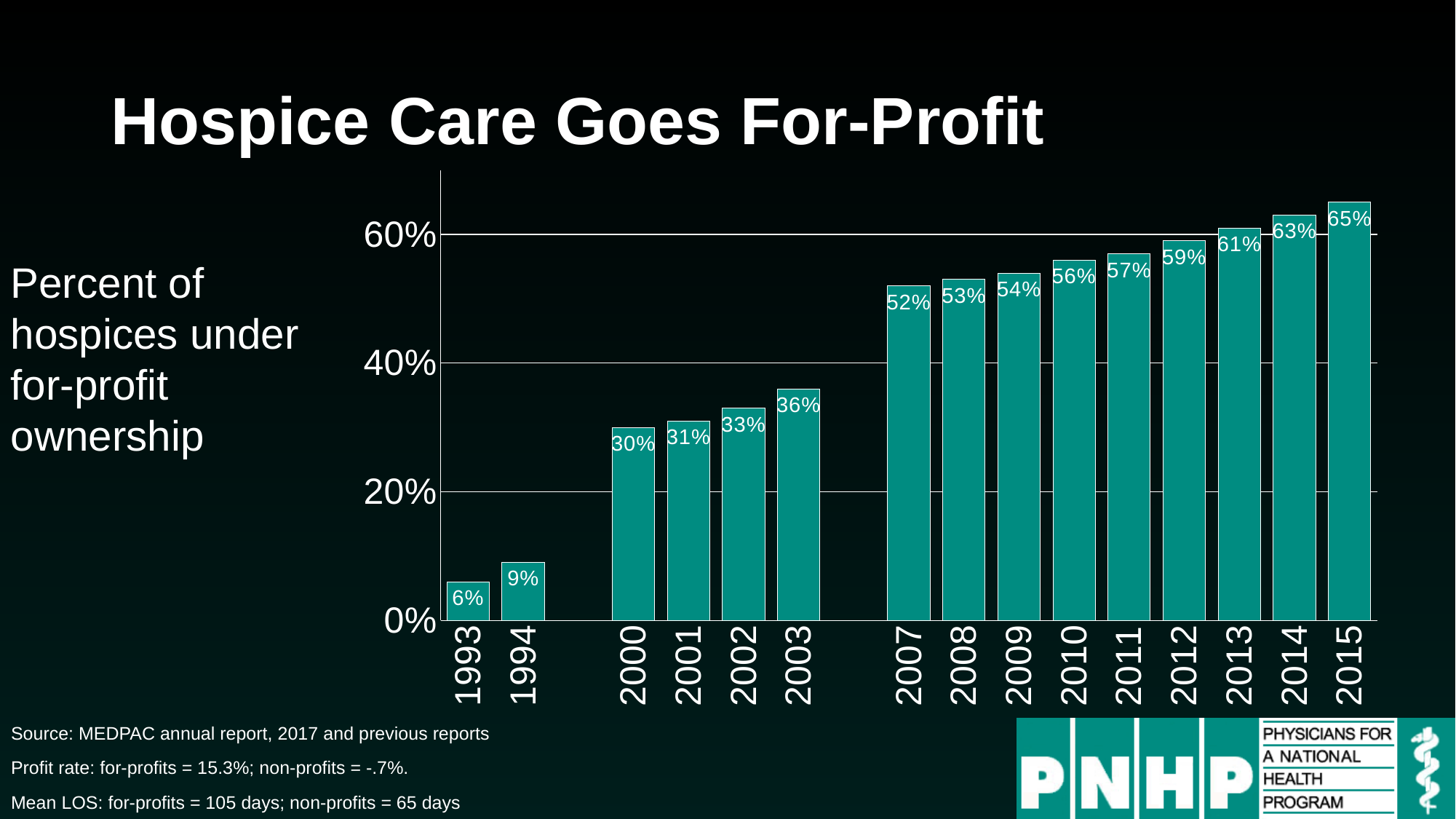
What is the value shown for 2007? 52% Which year has the lowest percent of hospices under for-profit ownership? 1993 What is the difference between the values for 2007 and 2003? 16% Which year has a larger value, 2000 or 2010? 2010 How many years are plotted on the chart? 15 What is the difference between the values for 2015 and 1993? 59% What kind of chart is shown on the slide? Bar chart What is the value shown for 2003? 36% Do the values rise or fall from 1993 to 2015? Rise What is the value shown for 2015? 65% What percent of hospices were under for-profit ownership in 1993? 6% Which year has the highest percent of hospices under for-profit ownership? 2015